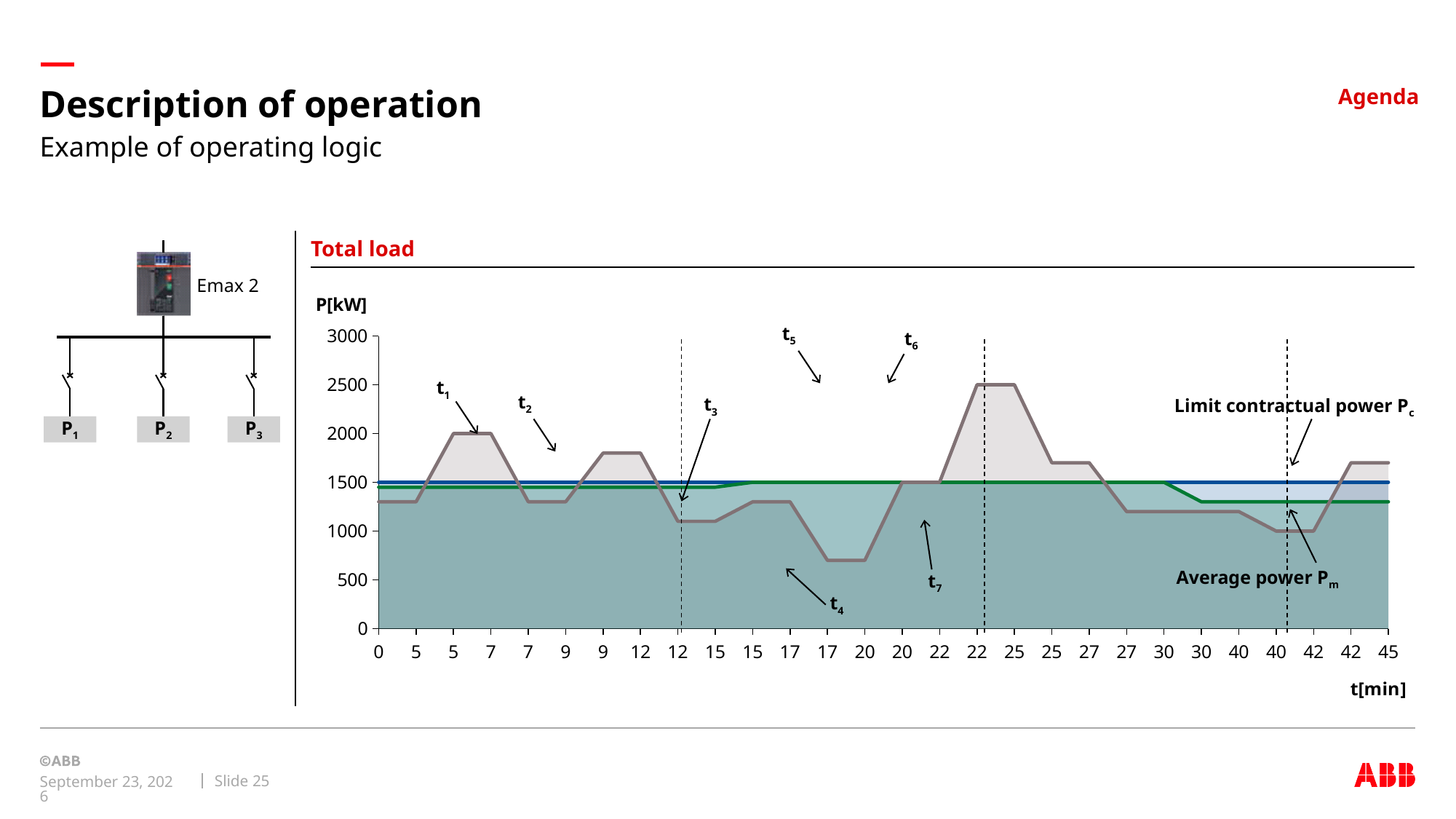
Is the lowest value of the total load curve (around t = 17 to 20 min) greater or less than 1000? less What value does the total load reach at its first peak, around t = 5 to 7 min? 2000 What are the axis labels of the chart? P[kW] on the vertical axis and t[min] on the horizontal axis At what value does the Limit contractual power Pc line sit? 1500 At t = 25 min, which is larger: the total load or the Limit contractual power Pc? total load How many time markers (t1 to t7) are annotated on the chart? 7 Is the Average power Pm at t = 40 min greater or less than 1500? less What is the title of the chart? Total load What is the maximum value shown on the vertical axis? 3000 What is the highest value reached by the total load curve? 2500